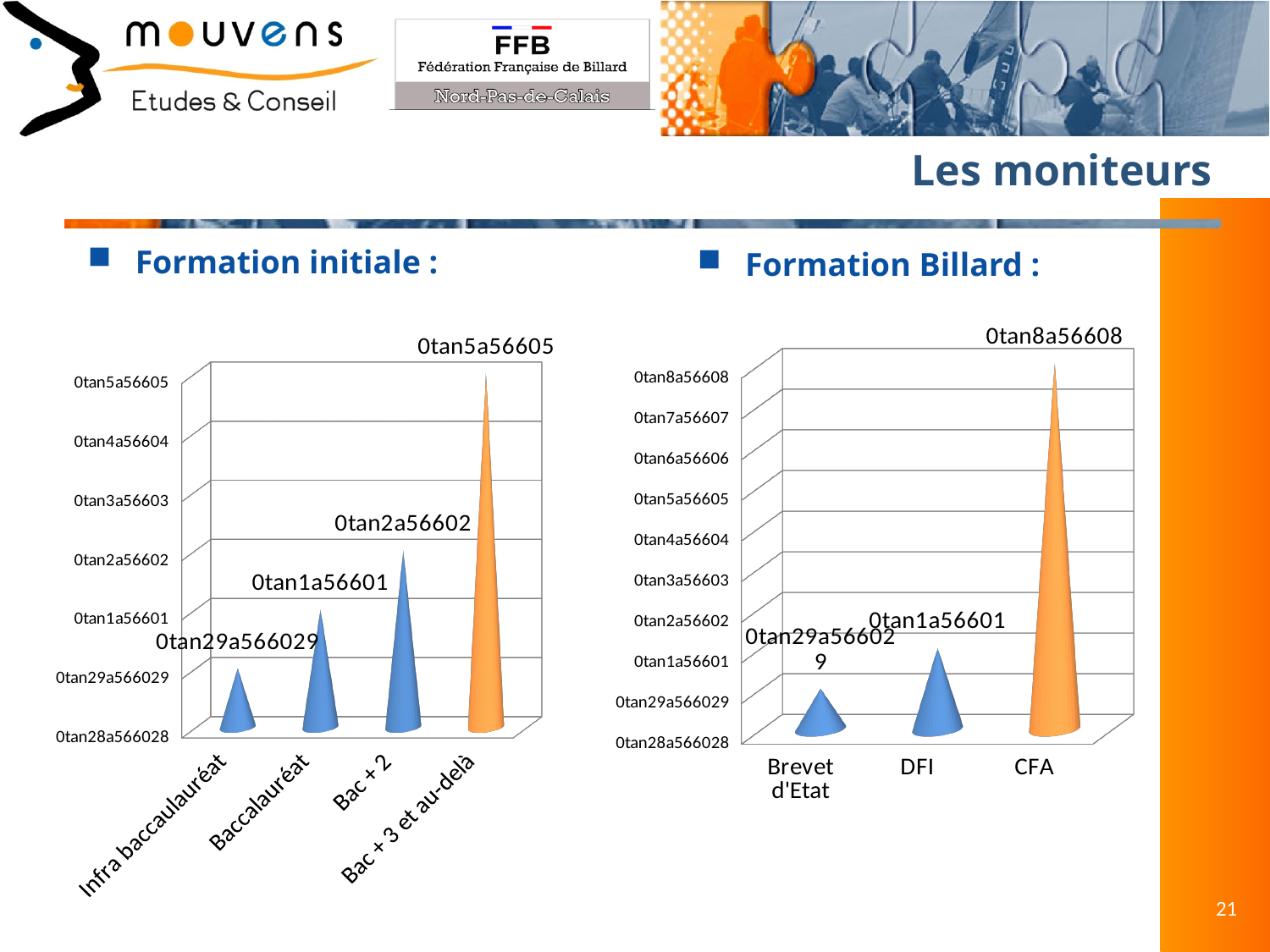
In the Formation Billard chart, what colour is the CFA bar? orange How many categories are shown in the Formation Billard chart? 3 In the Formation initiale chart, which is larger, the value for Baccalauréat or the value for Bac + 2? Bac + 2 In the Formation Billard chart, which category has the lowest value? Brevet d'Etat What kind of chart is the Formation Billard chart? bar chart In the Formation initiale chart, which category has the highest value? Bac + 3 et au-delà What is the data label shown above the Bac + 3 et au-delà bar in the Formation initiale chart? 0tan5a56605 In the Formation Billard chart, which category has the highest value? CFA In the Formation initiale chart, do the values rise or fall from left to right along the x axis? rise How many categories are shown in the Formation initiale chart? 4 In the Formation Billard chart, which is larger, the value for DFI or the value for CFA? CFA In the Formation initiale chart, which category has the lowest value? Infra baccaulauréat